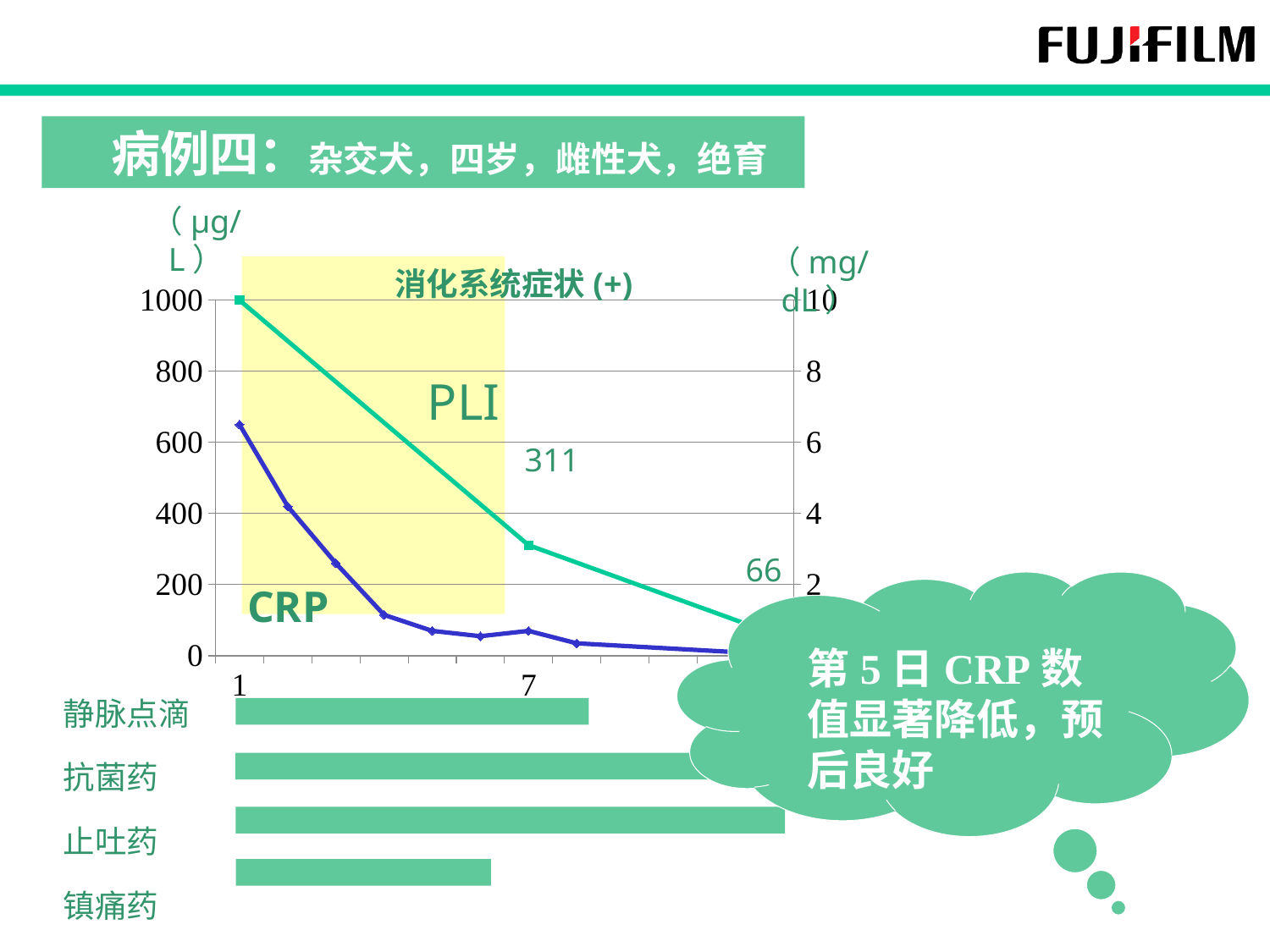
On which day is the PLI value highest? day 1 What is the PLI value on day 1? 1000 What is the difference between the PLI value on day 7 (311) and the final labelled PLI value (66)? 245 What kind of chart is shown on the slide? line chart Does the PLI line rise or fall over the days shown? fall What unit is shown on the right vertical axis? mg/dL Is the CRP value on day 1 greater or less than 4 mg/dL? greater What is the PLI value on day 7? 311 How many data series are plotted on the chart? 2 What is the last labelled PLI value on the chart? 66 What unit is shown on the left vertical axis? µg/L Which is larger, the PLI value on day 7 or the final labelled PLI value? day 7 (311)